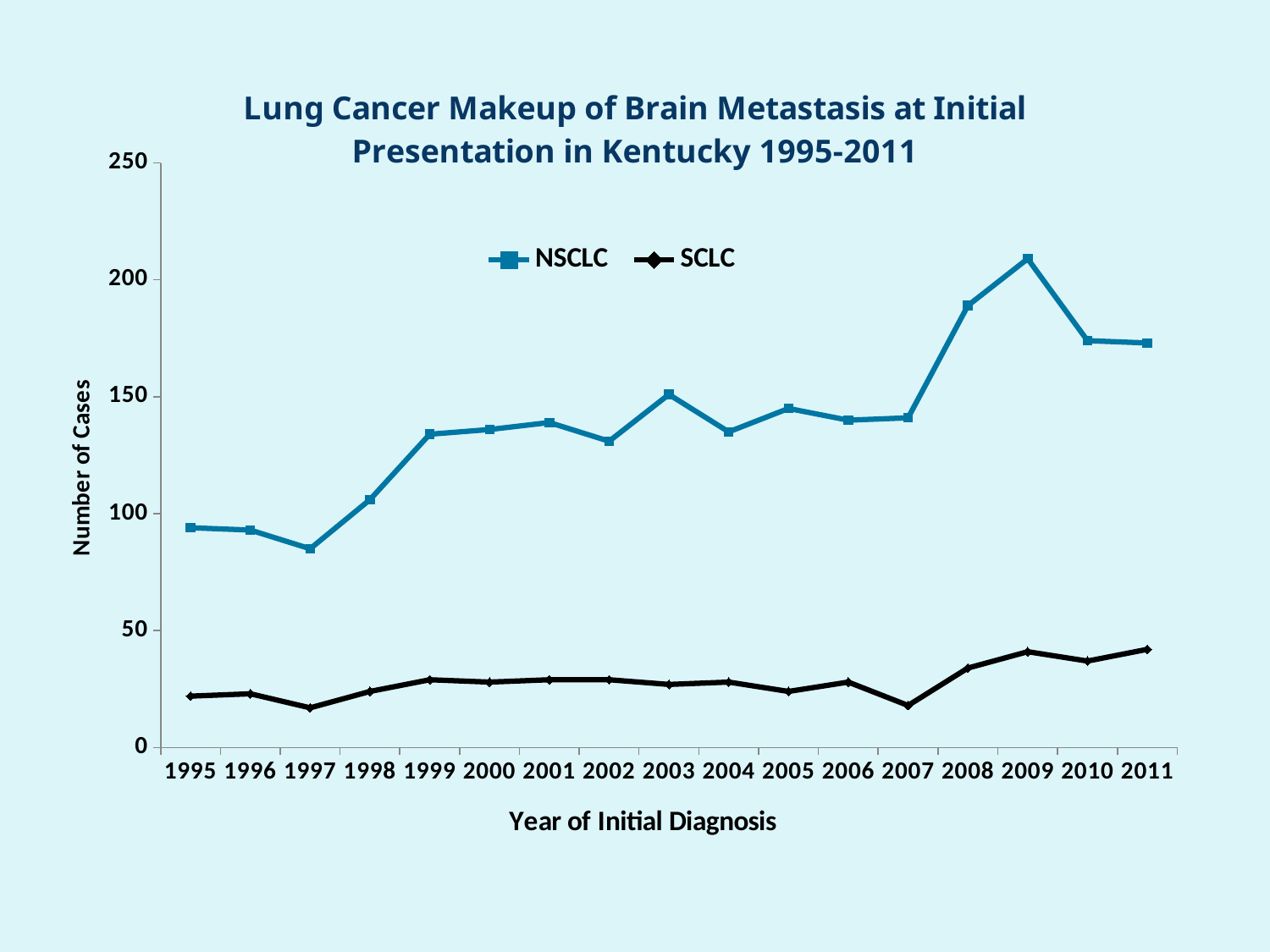
In which year does the NSCLC series reach its lowest value? 1997 How many series does the legend list? 2 Is the SCLC value for 2009 greater or less than 50? less What is the label on the y axis? Number of Cases Is the NSCLC value for 1997 greater or less than 100? less Which is larger, the NSCLC value for 2009 or for 2010? 2009 In which year does the NSCLC series reach its highest value? 2009 What kind of chart is shown on the slide? line chart Is the NSCLC value for 2009 greater or less than 200? greater Does the NSCLC series rise or fall from 2007 to 2009? rise How many years are plotted along the x axis? 17